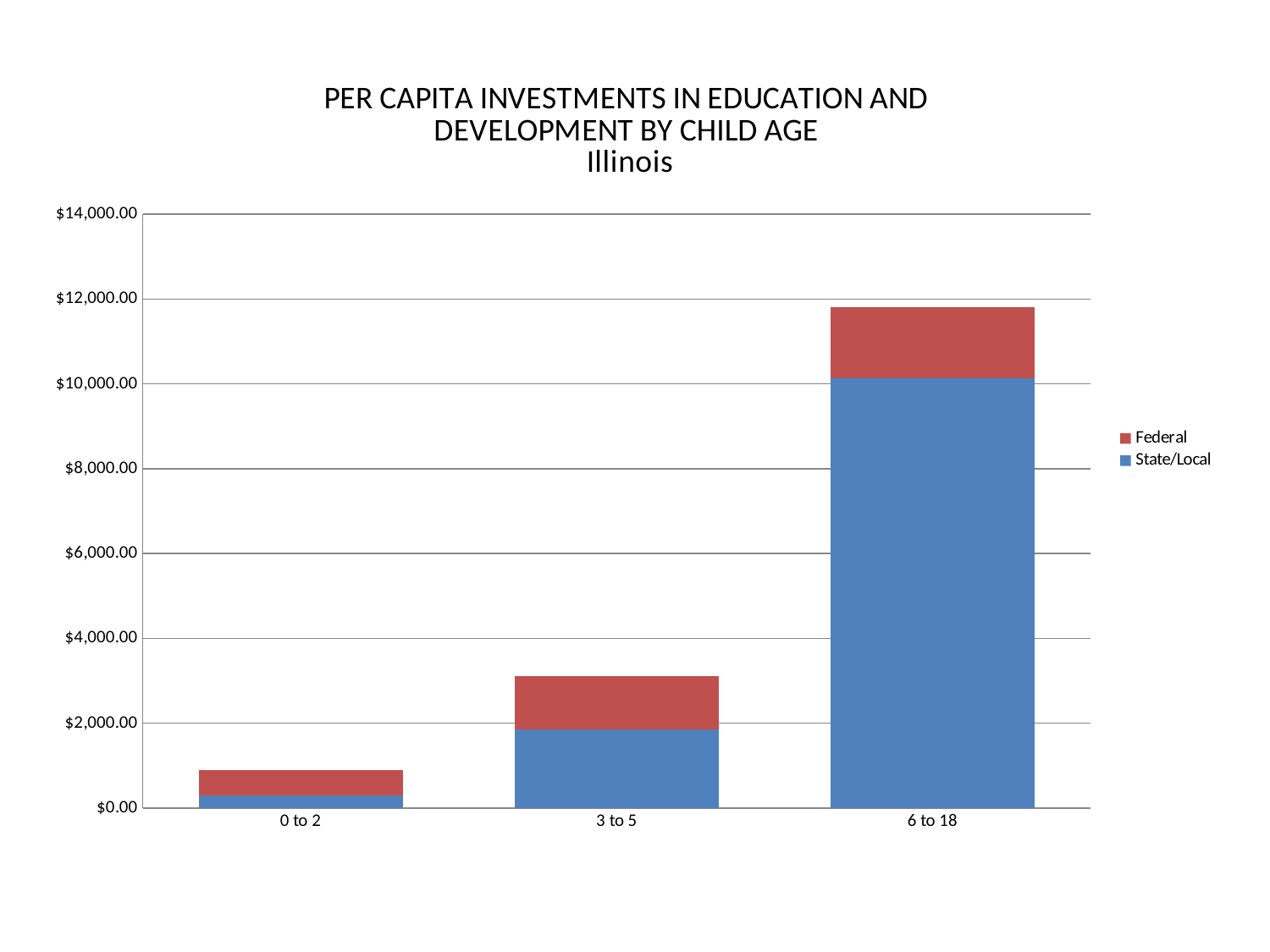
For the 6 to 18 age group, which is larger: the State/Local portion or the Federal portion? State/Local Which colour represents the Federal series in the legend? Red Is the State/Local investment for the 6 to 18 age group greater or less than $8,000.00? greater Which age group has the highest total per capita investment? 6 to 18 Is the total per capita investment for the 3 to 5 age group greater or less than $2,000.00? greater Which age group has the lowest total per capita investment? 0 to 2 Is the total per capita investment for the 6 to 18 age group greater or less than $10,000.00? greater What kind of chart is shown on the slide? Stacked bar chart How many age categories are shown on the x axis? 3 How many series does the legend list? 2 Do the total per capita investments rise or fall as child age increases along the x axis? rise